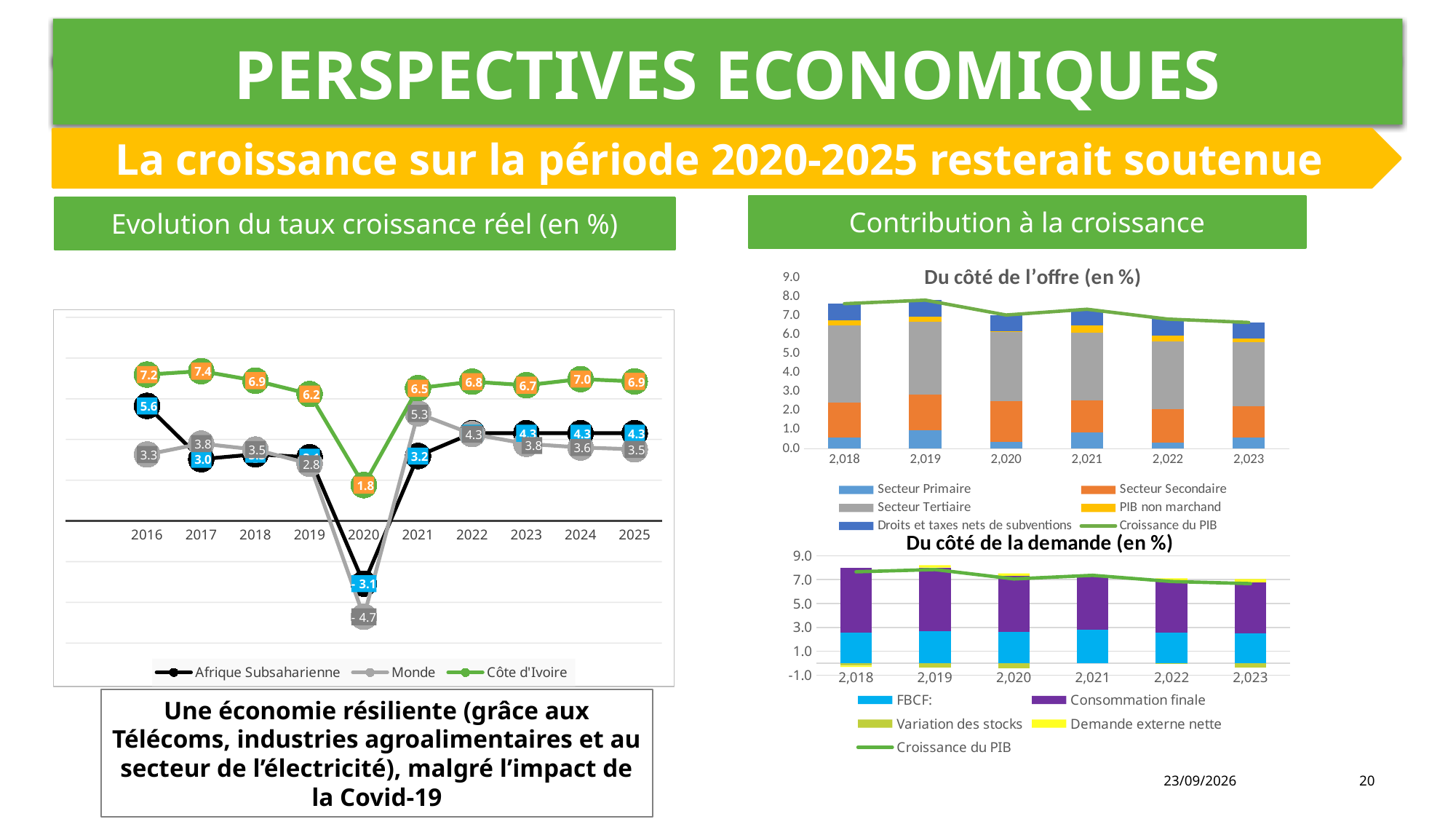
In the chart 'Evolution du taux croissance réel (en %)', how many series does the legend list? 3 In the chart 'Evolution du taux croissance réel (en %)', in which year is the Côte d'Ivoire value lowest? 2020 What kind of chart is 'Du côté de l'offre (en %)'? Stacked bar chart with a line In the chart 'Evolution du taux croissance réel (en %)', how many years are shown on the x axis? 10 In the chart 'Evolution du taux croissance réel (en %)', what is the value for Afrique Subsaharienne in 2016? 5.6 In the chart 'Du côté de la demande (en %)', how many series does the legend list? 5 In the chart 'Evolution du taux croissance réel (en %)', what is the value for Côte d'Ivoire in 2020? 1.8 In the chart 'Du côté de l'offre (en %)', is the Croissance du PIB value for 2019 greater or less than 7.0? greater In the chart 'Evolution du taux croissance réel (en %)', what is the value for Monde in 2020? -4.7 In the chart 'Evolution du taux croissance réel (en %)', in which year is the Côte d'Ivoire value highest? 2017 In the chart 'Evolution du taux croissance réel (en %)', what is the difference between the Côte d'Ivoire values in 2017 and 2020? 5.6 In the chart 'Evolution du taux croissance réel (en %)', which is larger in 2020: Afrique Subsaharienne or Monde? Afrique Subsaharienne